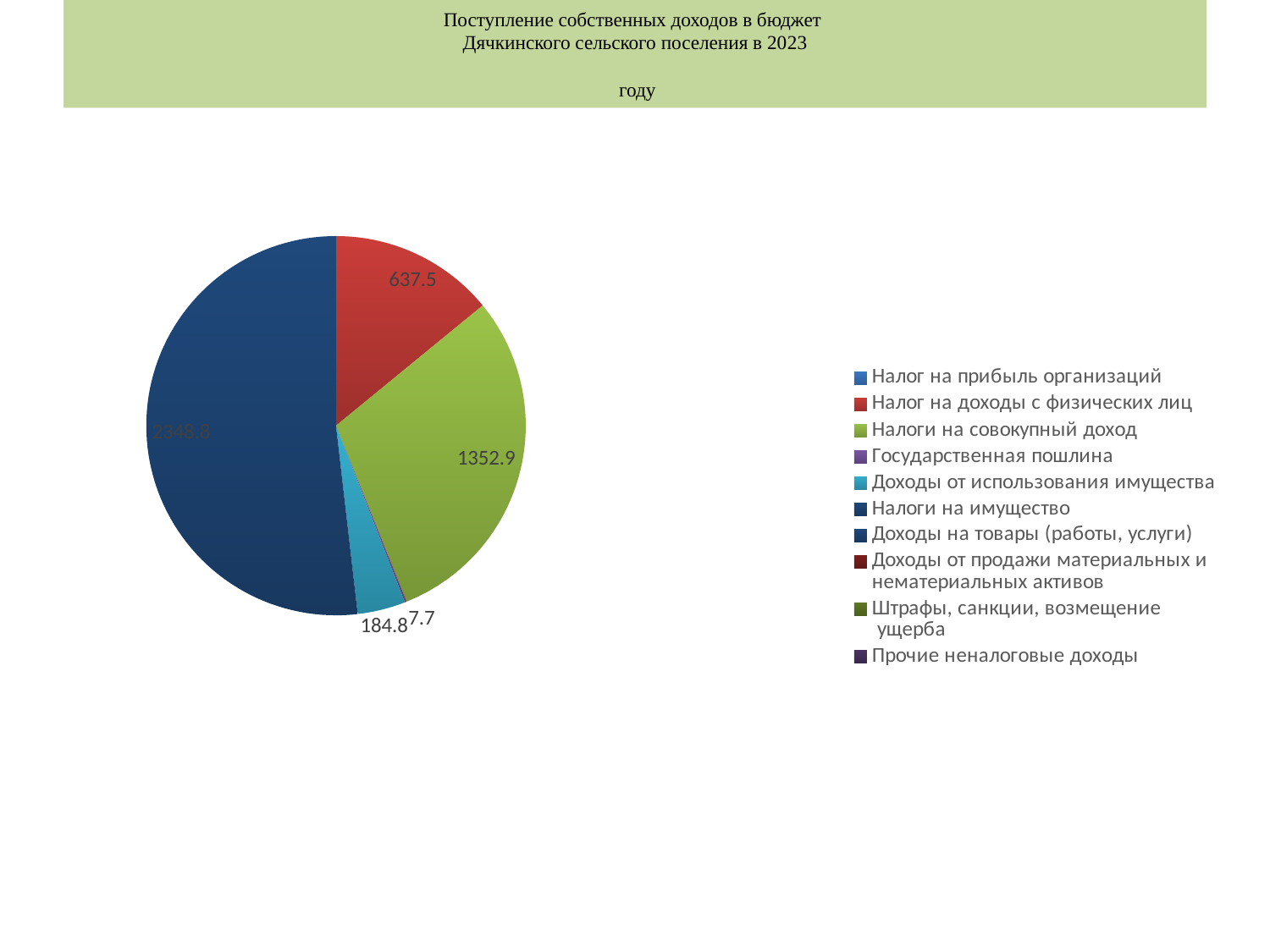
What colour is the slice for Налоги на совокупный доход? green What is the value for Налоги на имущество? 2348.8 How many entries does the legend list? 10 What is the difference between the values for Налоги на совокупный доход and Налог на доходы с физических лиц? 715.4 Which is larger: Налог на доходы с физических лиц or Доходы от использования имущества? Налог на доходы с физических лиц Which category has the largest slice of the pie? Налоги на имущество What kind of chart is shown on the slide? pie chart What is the value for Доходы от использования имущества? 184.8 What is the value for Налог на доходы с физических лиц? 637.5 What is the value for Государственная пошлина? 7.7 What is the value for Налоги на совокупный доход? 1352.9 Which of the labelled slices has the smallest value? Государственная пошлина